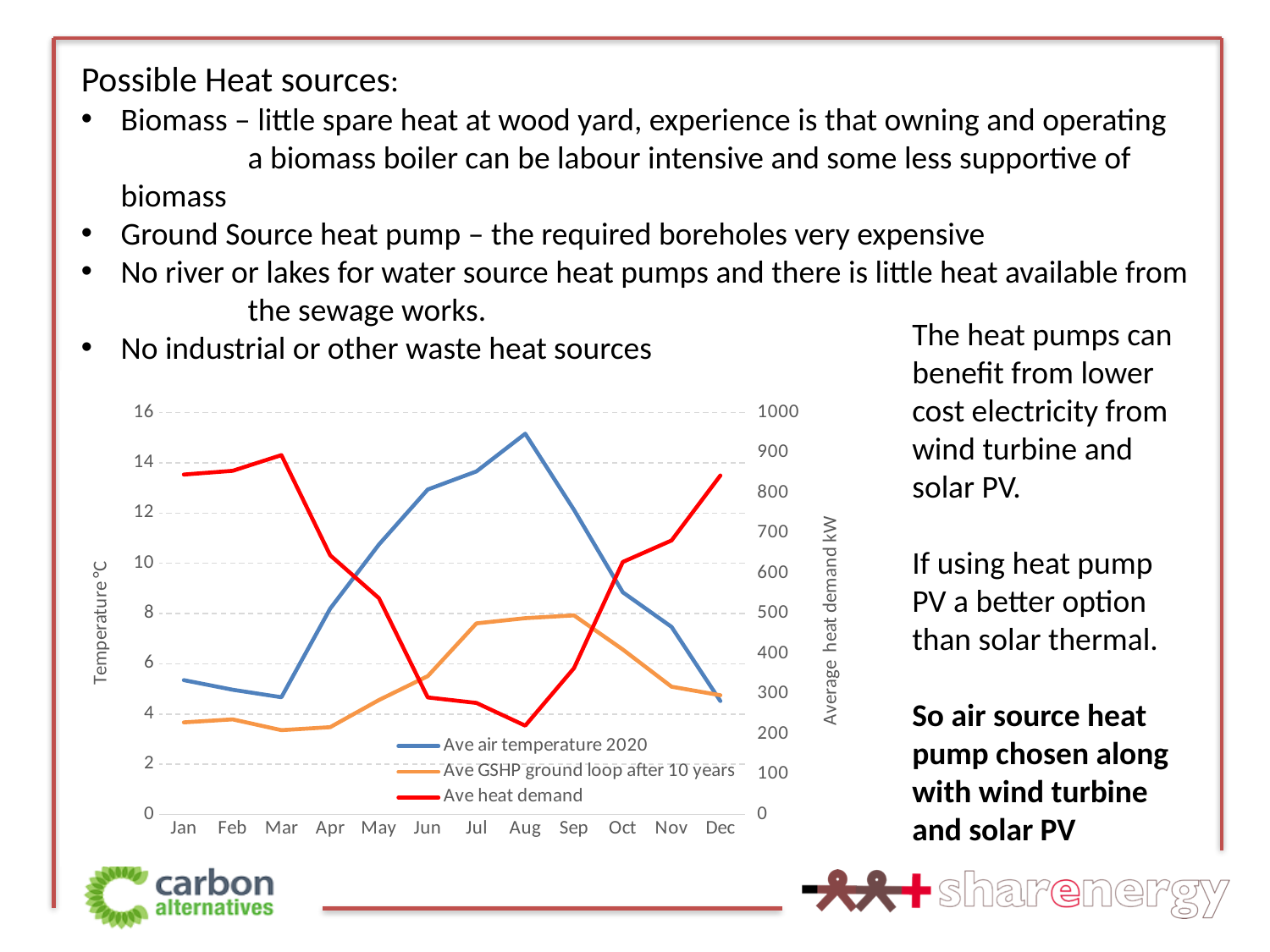
How many months are plotted along the x axis of the chart? 12 Does the Ave air temperature 2020 series rise or fall from Mar to Aug? rise In which month does the Ave GSHP ground loop after 10 years series reach its highest value? Sep What kind of chart is shown on the slide? line chart Is the Ave air temperature 2020 value for Aug greater or less than 14? greater In Jul, which is higher: Ave air temperature 2020 or Ave GSHP ground loop after 10 years? Ave air temperature 2020 Is the Ave GSHP ground loop after 10 years value for Sep greater or less than 6? greater In which month does the Ave air temperature 2020 series reach its highest value? Aug Is the Ave heat demand value for Aug greater or less than 300? less What is the title of the right-hand vertical axis of the chart? Average heat demand kW How many series does the chart's legend list? 3 In which month is the Ave heat demand series at its lowest? Aug